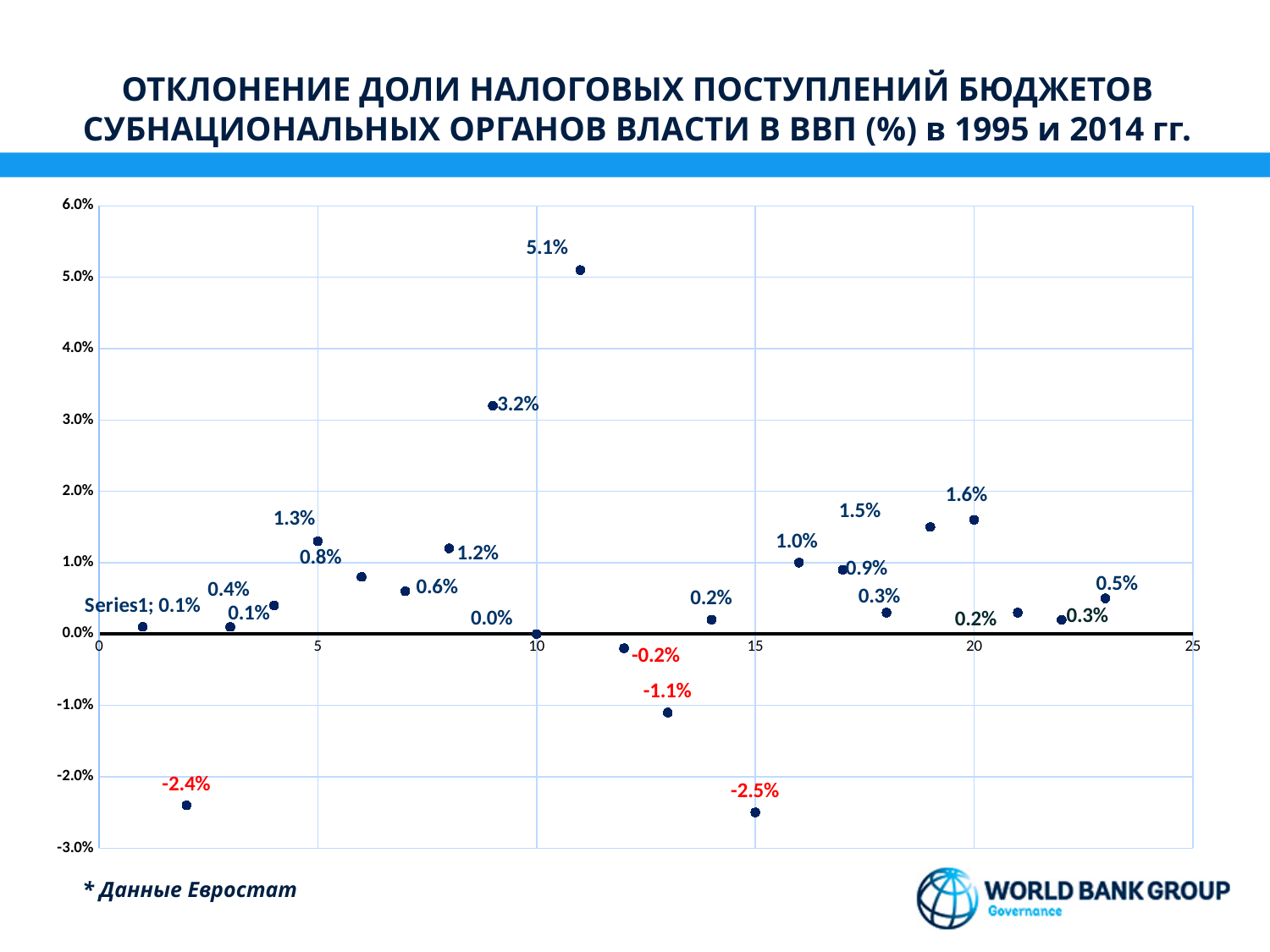
What is the maximum value shown on the vertical axis? 6.0% What is the value of the point at x = 9? 3.2% What is the lowest value plotted on the chart? -2.5% What is the value of the point at x = 2? -2.4% What kind of chart is shown on the slide? scatter chart How many data points are plotted on the chart? 23 What is the highest value plotted on the chart? 5.1% What is the value of the point at x = 20? 1.6% Which is larger, the value at x = 19 (1.5%) or the value at x = 16 (1.0%)? 1.5% What is the value of the point at x = 10? 0.0% How many of the plotted values are negative? 4 What is the difference between the highest value (5.1%) and the value 3.2%? 1.9%